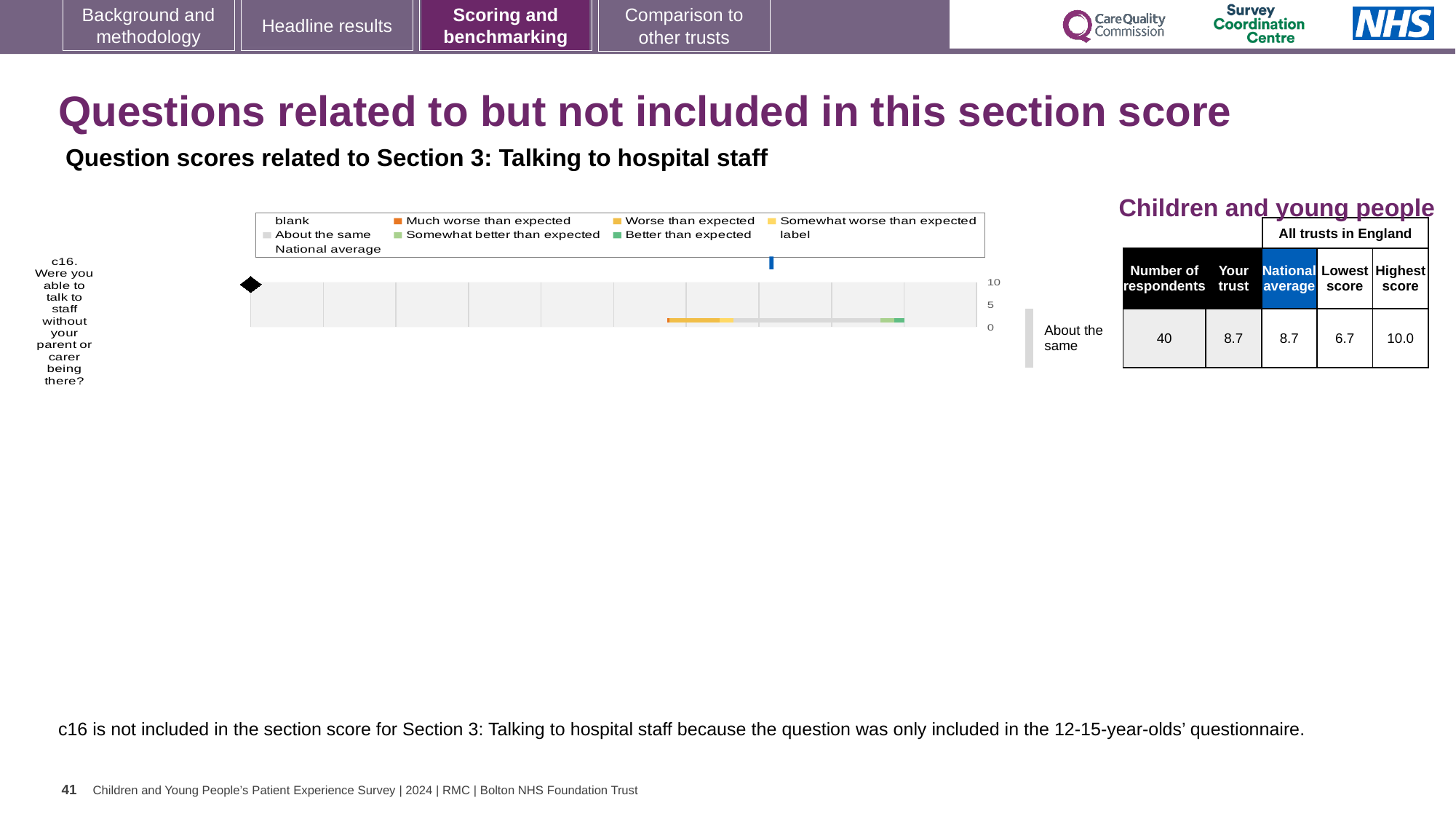
What is the highest tick value shown on the chart's axis? 10 What kind of chart is shown on the slide? bar chart Which question is plotted in the chart? c16. Were you able to talk to staff without your parent or carer being there? In the table beside the chart, what is the number of respondents for c16? 40 In the table beside the chart, what is the 'Your trust' score for c16? 8.7 In the table beside the chart, what is the highest score among all trusts in England for c16? 10.0 Is the 'Your trust' score for c16 larger than, smaller than, or equal to the national average? equal What benchmark category is shown next to the bar for c16? About the same In the table beside the chart, what is the national average score for c16? 8.7 What is the difference between the highest score and the lowest score for c16 in the table beside the chart? 3.3 In the table beside the chart, what is the lowest score among all trusts in England for c16? 6.7 How many questions (categories) are plotted in the chart? 1